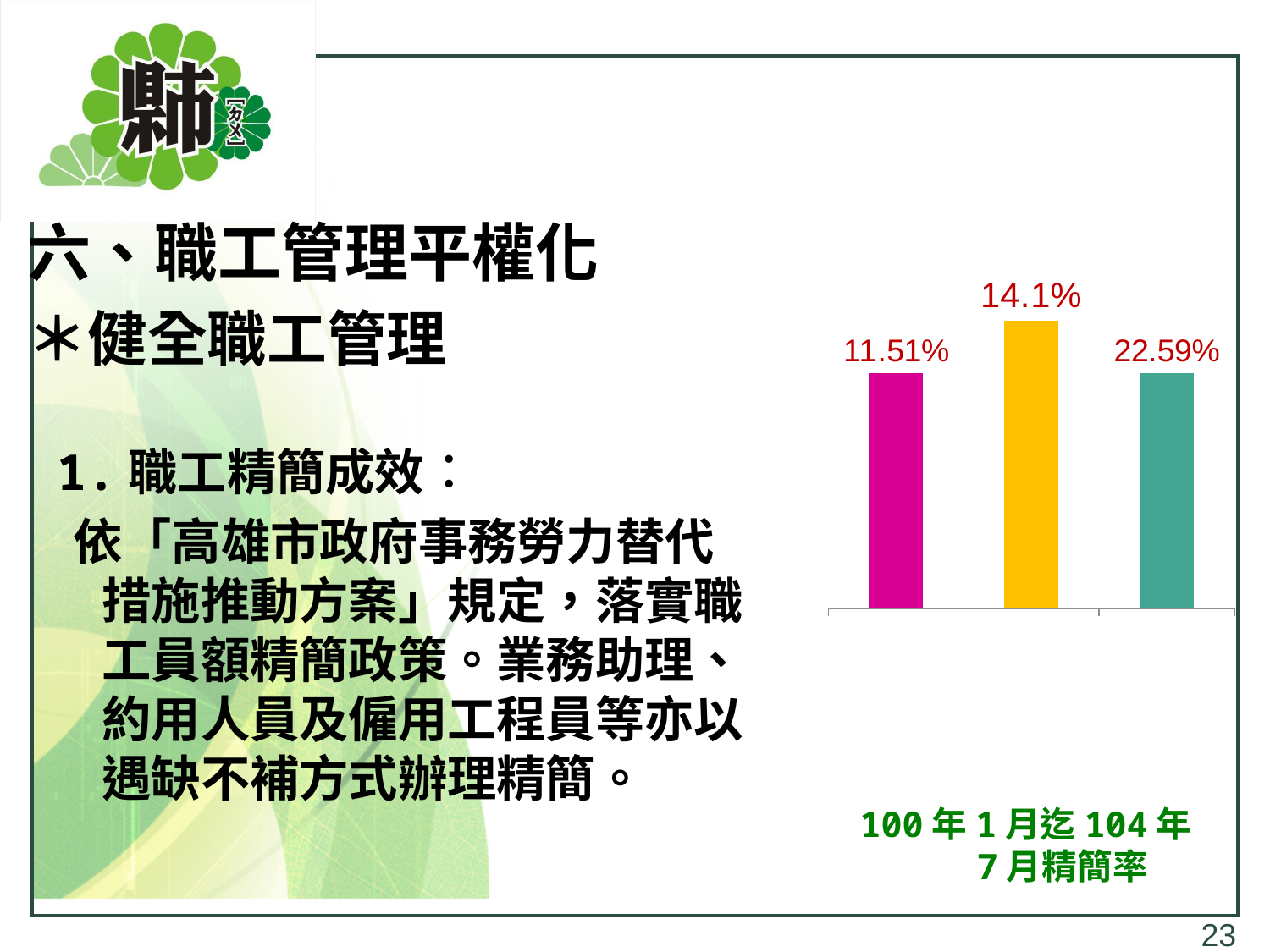
What value is labelled on the middle (yellow) bar? 14.1% What caption is printed below the chart? 100年1月迄104年7月精簡率 Which labelled value is larger, the middle bar's or the right bar's? the right bar's (22.59%) What colour is the middle bar in the chart? yellow What kind of chart is shown on the right side of the slide? bar chart Which bar has the lowest labelled value? the left (magenta) bar, 11.51% What is the difference between the labelled values of the right bar and the left bar? 11.08% How many bars are plotted in the chart? 3 What value is labelled on the right (teal) bar? 22.59% What value is labelled on the left (magenta) bar? 11.51% What is the difference between the labelled values of the middle bar and the left bar? 2.59% Which bar has the highest labelled value? the right (teal) bar, 22.59%